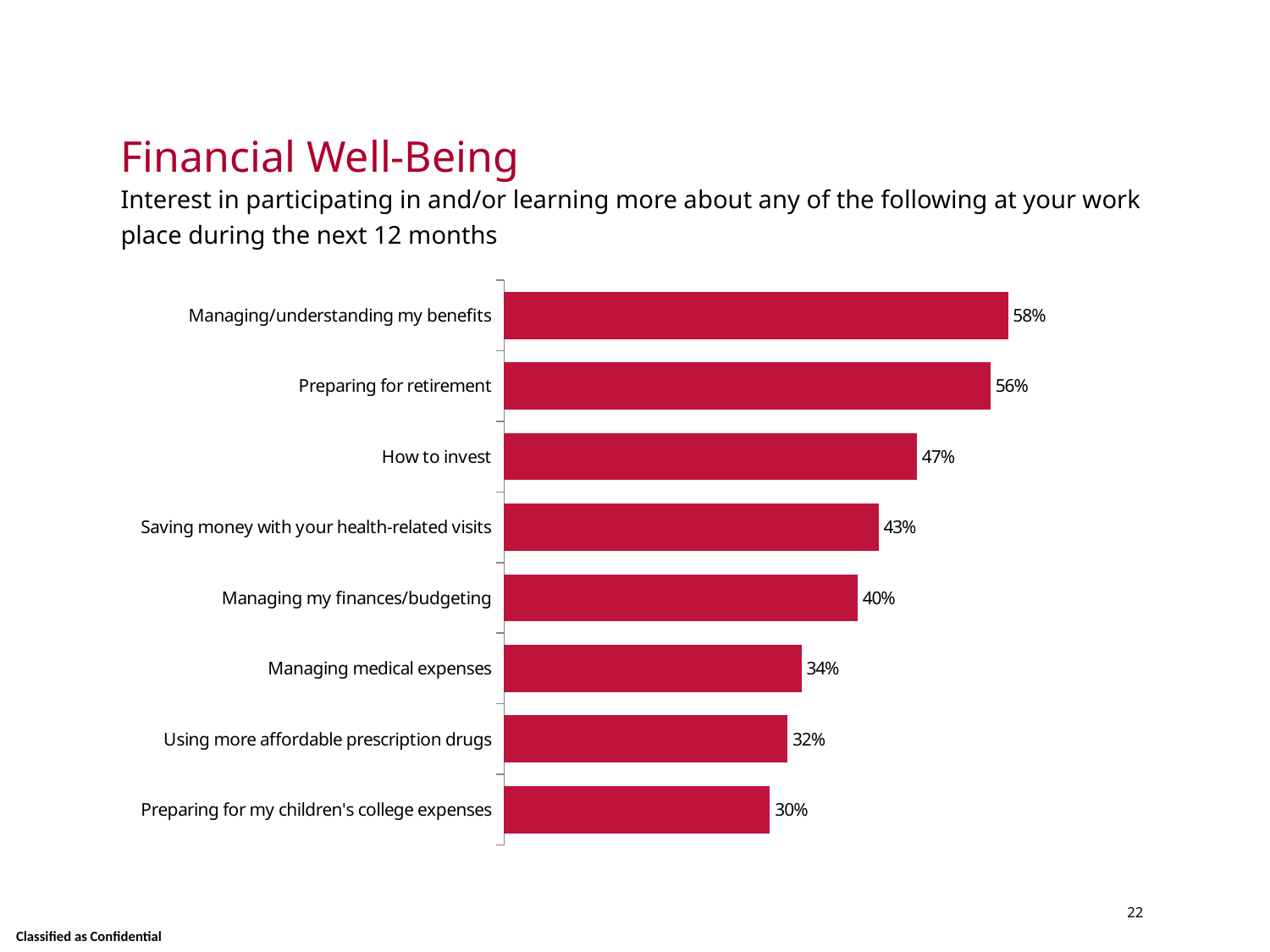
What is the difference between the values for how to invest and managing my finances/budgeting? 7% What colour are the bars in the chart? Red Which has a larger value: saving money with your health-related visits or using more affordable prescription drugs? Saving money with your health-related visits Which category has the highest value? Managing/understanding my benefits Do the values increase or decrease from the top bar to the bottom bar? Decrease What is the value shown for preparing for retirement? 56% What percentage of respondents are interested in managing/understanding my benefits? 58% What is the difference between the values for managing/understanding my benefits and preparing for my children's college expenses? 28% Which category has the lowest value? Preparing for my children's college expenses What is the value shown for managing medical expenses? 34% How many categories are shown in the chart? 8 What kind of chart is shown on the slide? Bar chart